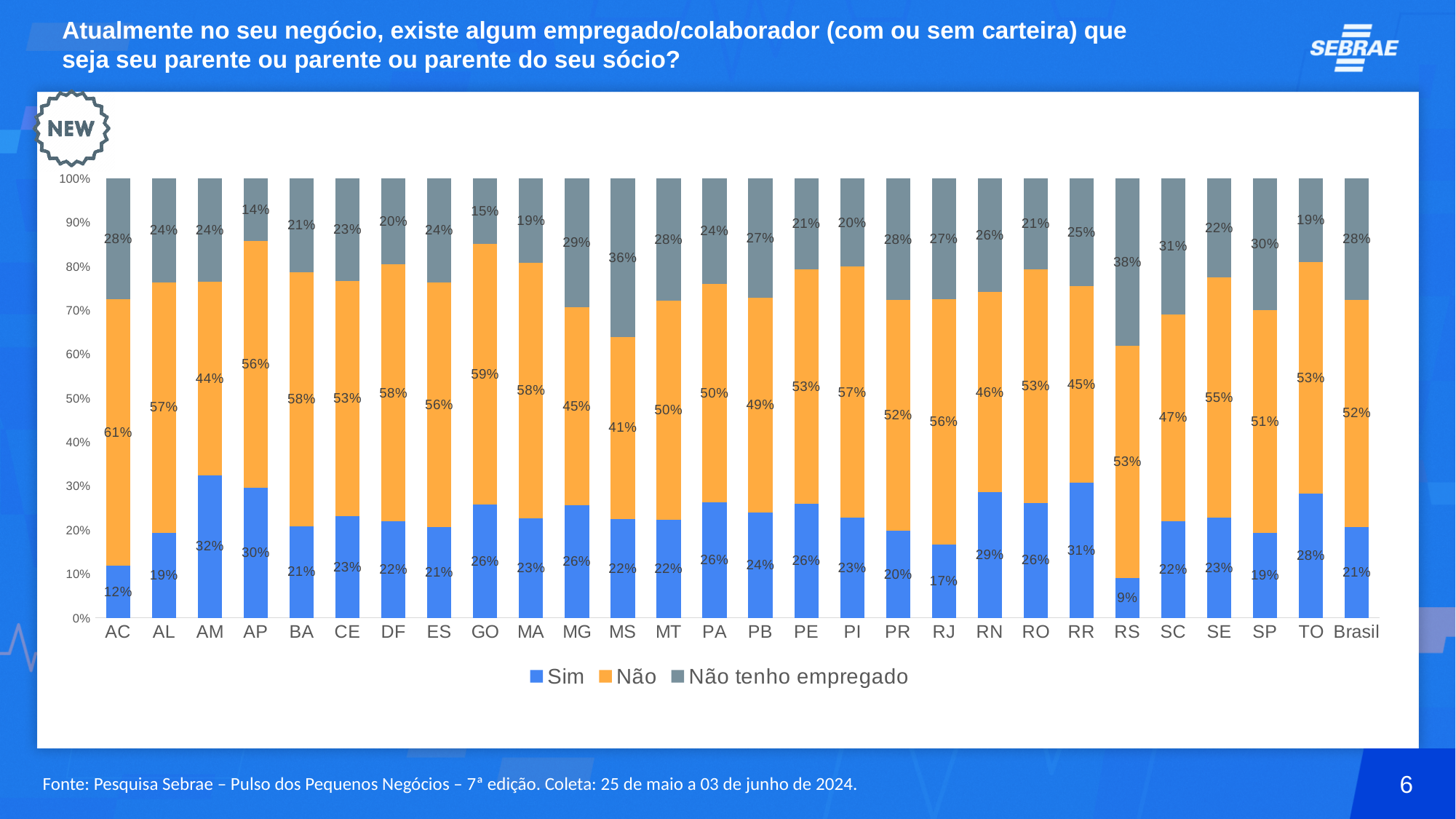
Which state has the lowest value for the "Sim" series? RS What is the difference between the "Sim" values for AM and RS? 23% Which is larger, the "Não" value for GO or the "Não" value for MG? GO Which state has the lowest value for the "Não tenho empregado" series? AP Which state has the highest value for the "Sim" series? AM What kind of chart is shown on the slide? Stacked bar chart How many categories are shown on the x axis? 28 What is the value of the "Não" series for AC? 61% What is the value of the "Não tenho empregado" series for RS? 38% How many series does the legend list? 3 Which state has the lowest value for the "Não" series? MS What is the value of the "Sim" series for Brasil? 21%